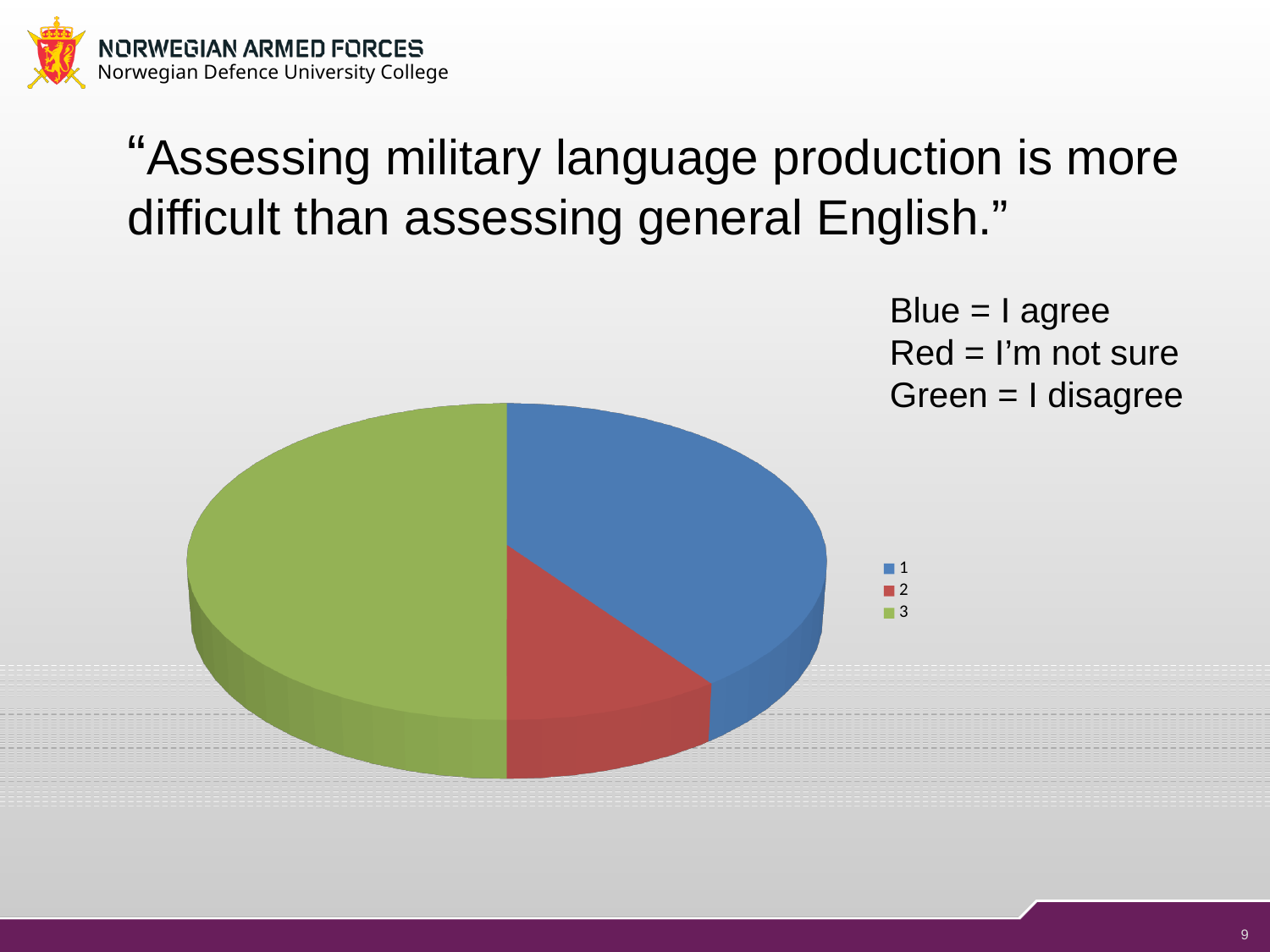
Which response received the most votes according to the pie chart? I disagree Which response does the green slice represent according to the slide? I disagree Which slice is larger, the blue slice (1) or the red slice (2)? Blue (1) Which response received the fewest votes according to the pie chart? I'm not sure Which colour represents the response "I'm not sure"? Red How many entries does the chart legend list? 3 Which slice of the pie chart is the largest? 3 (green, I disagree) Which slice is larger, the green slice (3) or the blue slice (1)? Green (3) How many slices does the pie chart have? 3 What kind of chart is shown on the slide? Pie chart Which slice of the pie chart is the smallest? 2 (red, I'm not sure)